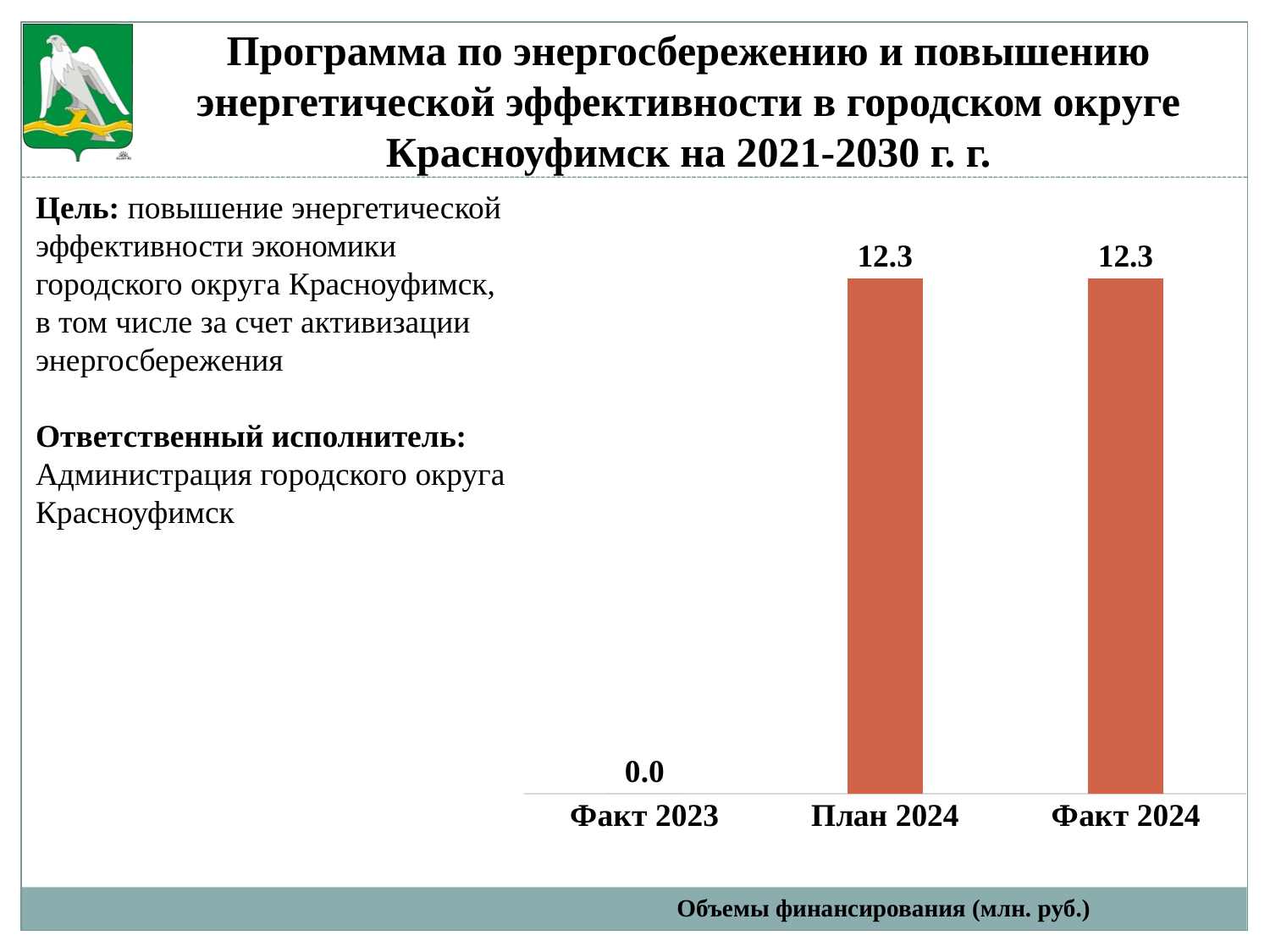
What is the difference between the values for План 2024 and Факт 2024? 0.0 What caption is shown below the chart? Объемы финансирования (млн. руб.) Which is larger, the value for Факт 2023 or the value for Факт 2024? Факт 2024 What is the difference between the values for Факт 2024 and Факт 2023? 12.3 Which category has the lowest value? Факт 2023 What is the value for Факт 2024? 12.3 Do the values rise or fall from Факт 2023 to План 2024? Rise What kind of chart is shown on the slide? Bar chart How many categories are shown on the chart? 3 Is the value for План 2024 larger than, smaller than, or equal to the value for Факт 2024? Equal What is the value for Факт 2023? 0.0 What is the value for План 2024? 12.3